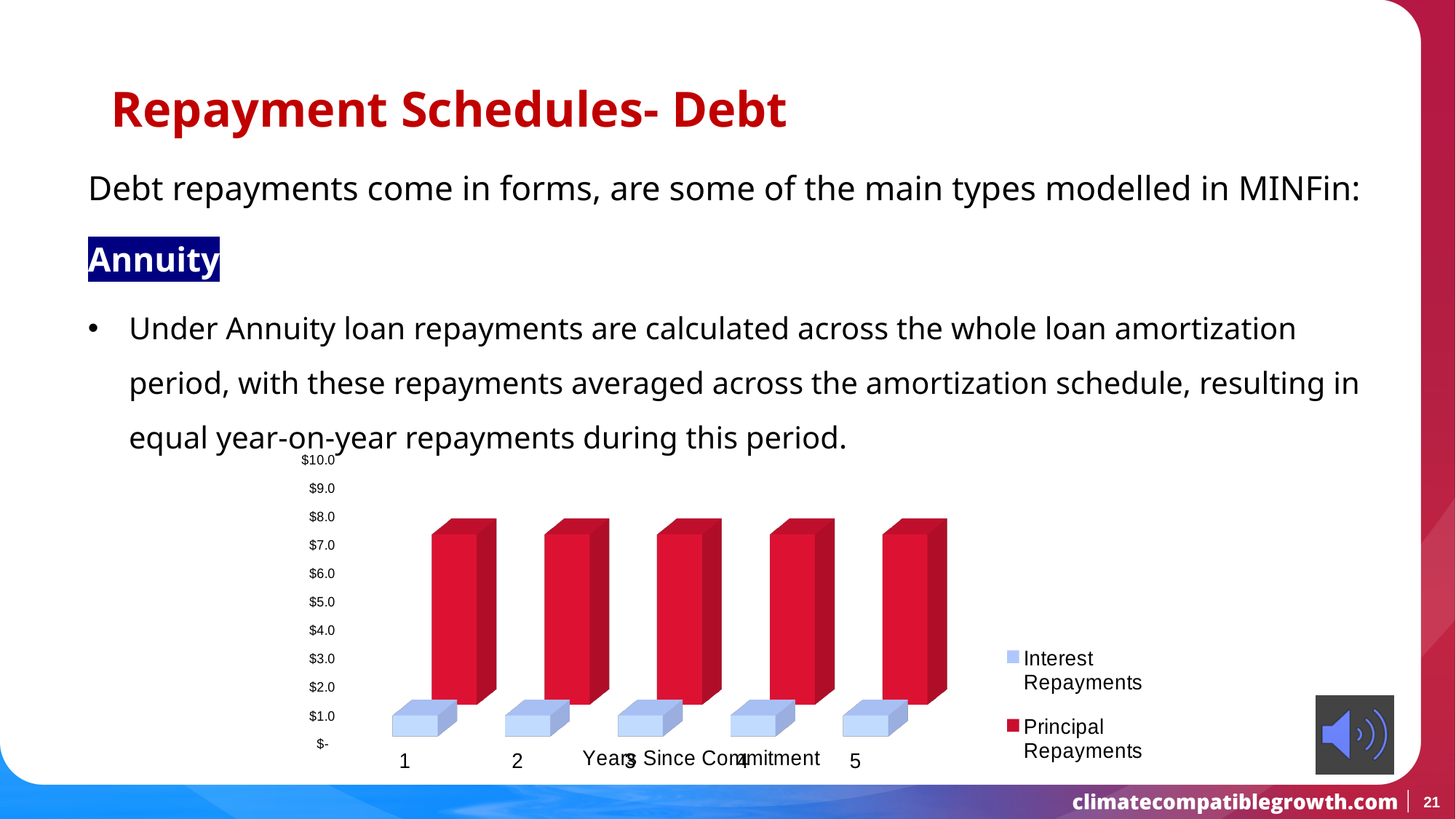
Do the Principal Repayments values rise, fall, or stay the same from year 1 to year 5? stay the same What is the title of the x axis of the chart? Years Since Commitment Is the value for Principal Repayments in year 1 greater or less than $5.0? greater How many categories (years) are shown on the x axis of the chart? 5 What are the two series named in the chart's legend? Interest Repayments and Principal Repayments In year 3, which is larger: Principal Repayments or Interest Repayments? Principal Repayments How many series does the chart's legend list? 2 Do the Interest Repayments values rise, fall, or stay the same across the years shown? stay the same Is the value for Interest Repayments in year 1 greater or less than $3.0? less Is the value for Interest Repayments in year 3 greater or less than $4.0? less What kind of chart is shown on the slide? bar chart